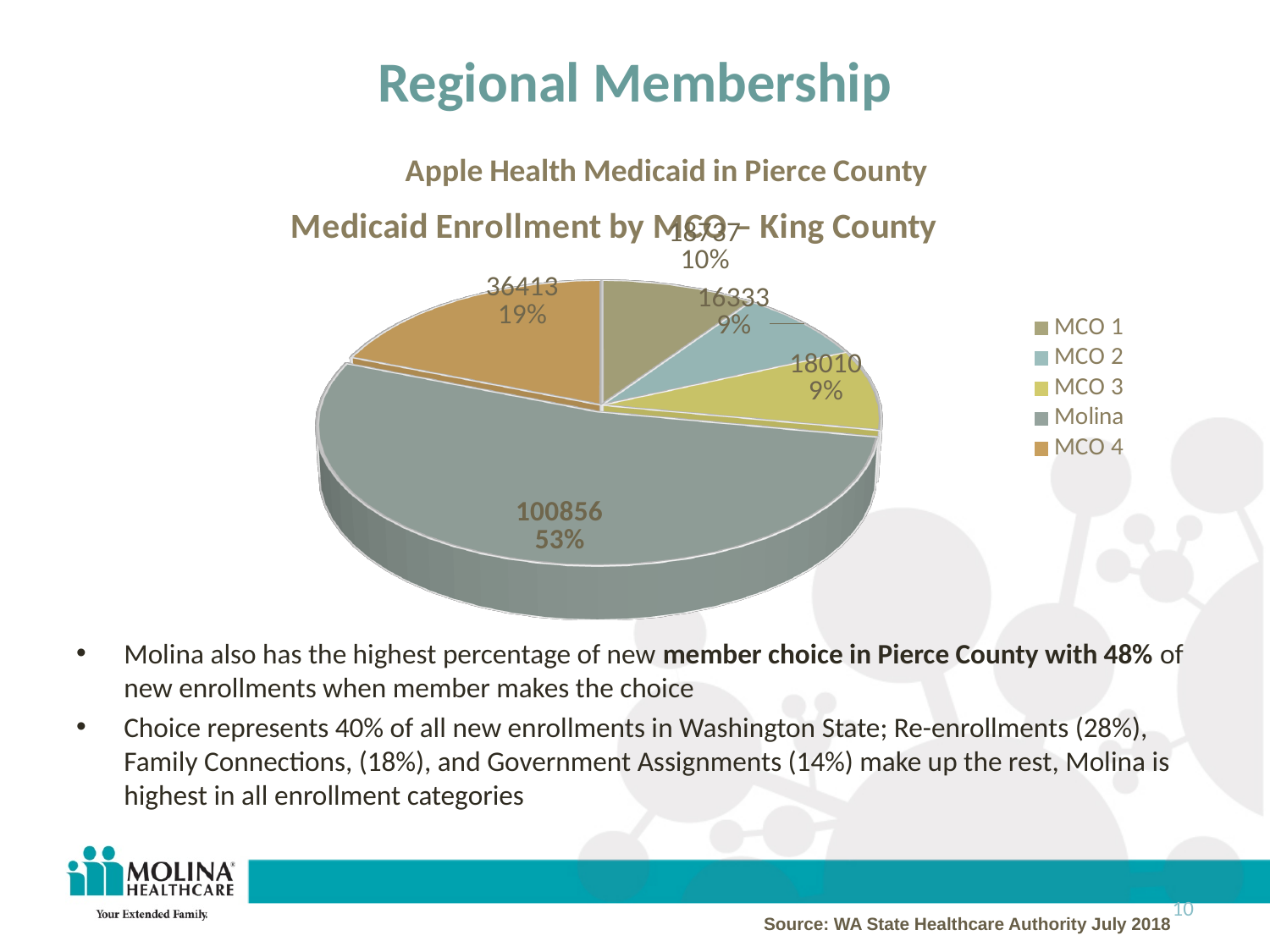
Which MCO has the smallest slice of the pie? MCO 2 What is the enrollment value shown for MCO 4? 36413 Which has the larger enrollment value, MCO 2 or MCO 3? MCO 3 What share of the pie does MCO 4 represent? 19% What is the enrollment value shown for Molina in the pie chart? 100856 What share of the pie does MCO 2 represent? 9% What share of the pie does Molina represent? 53% What is the difference between the enrollment values for Molina and MCO 4? 64443 How many entries does the legend of the pie chart list? 5 How many slices does the pie chart have? 5 Which MCO has the largest slice of the pie? Molina What kind of chart is shown on the slide? Pie chart